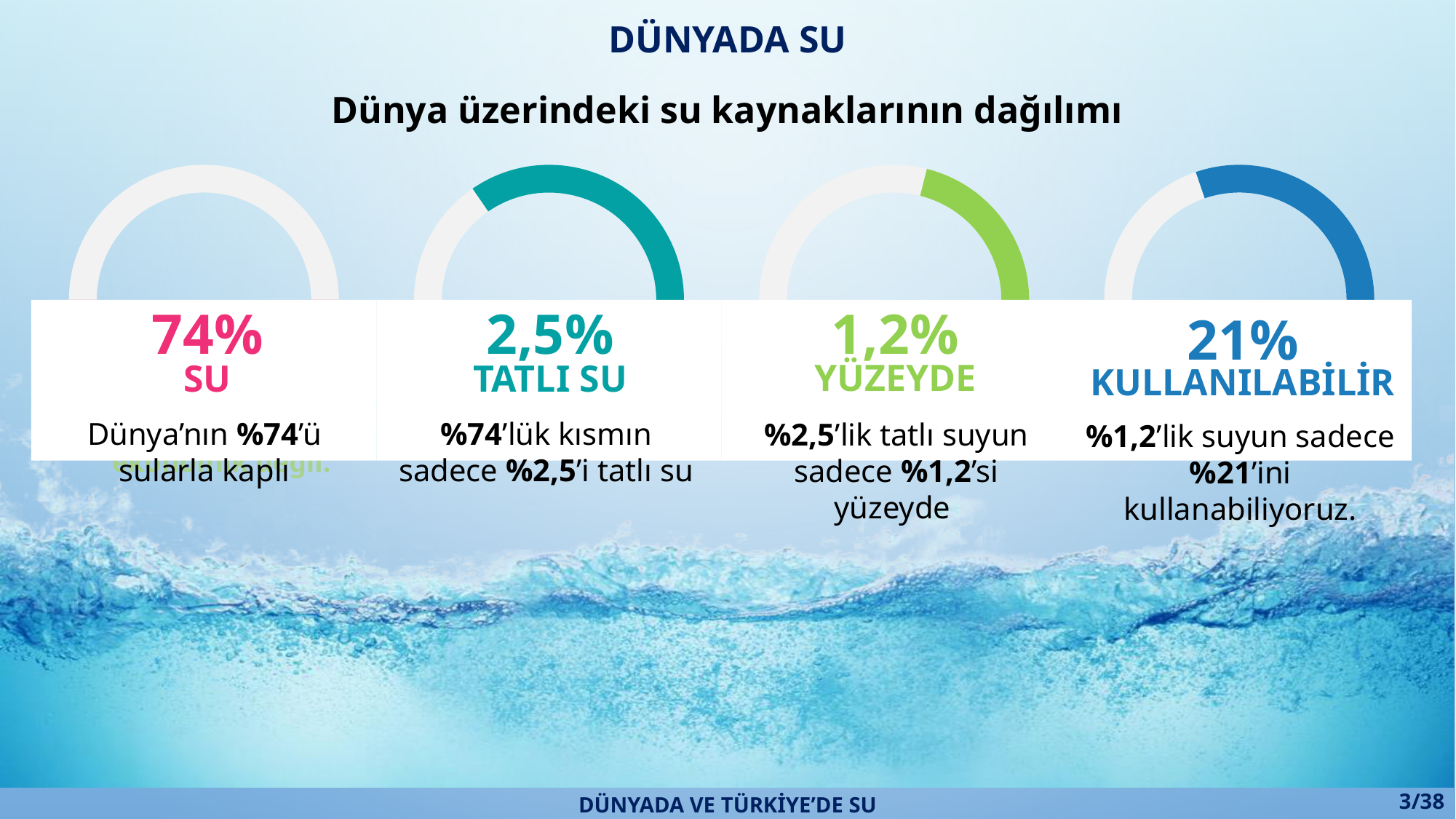
What is the difference between the TATLI SU percentage and the YÜZEYDE percentage? 1,3% What kind of chart is used to show each percentage on the slide? Ring (donut) chart What percentage is shown for the chart labelled KULLANILABİLİR? 21% What colour is the filled portion of the ring chart labelled KULLANILABİLİR? Blue Which is larger, the percentage for TATLI SU or the percentage for YÜZEYDE? TATLI SU What percentage is shown for the chart labelled TATLI SU? 2,5% Which of the four ring charts shows the lowest percentage? YÜZEYDE What percentage is shown for the chart labelled YÜZEYDE? 1,2% How many ring charts are shown on the slide? 4 What is the difference between the SU percentage and the KULLANILABİLİR percentage? 53% Which of the four ring charts shows the highest percentage? SU What percentage is shown for the chart labelled SU? 74%